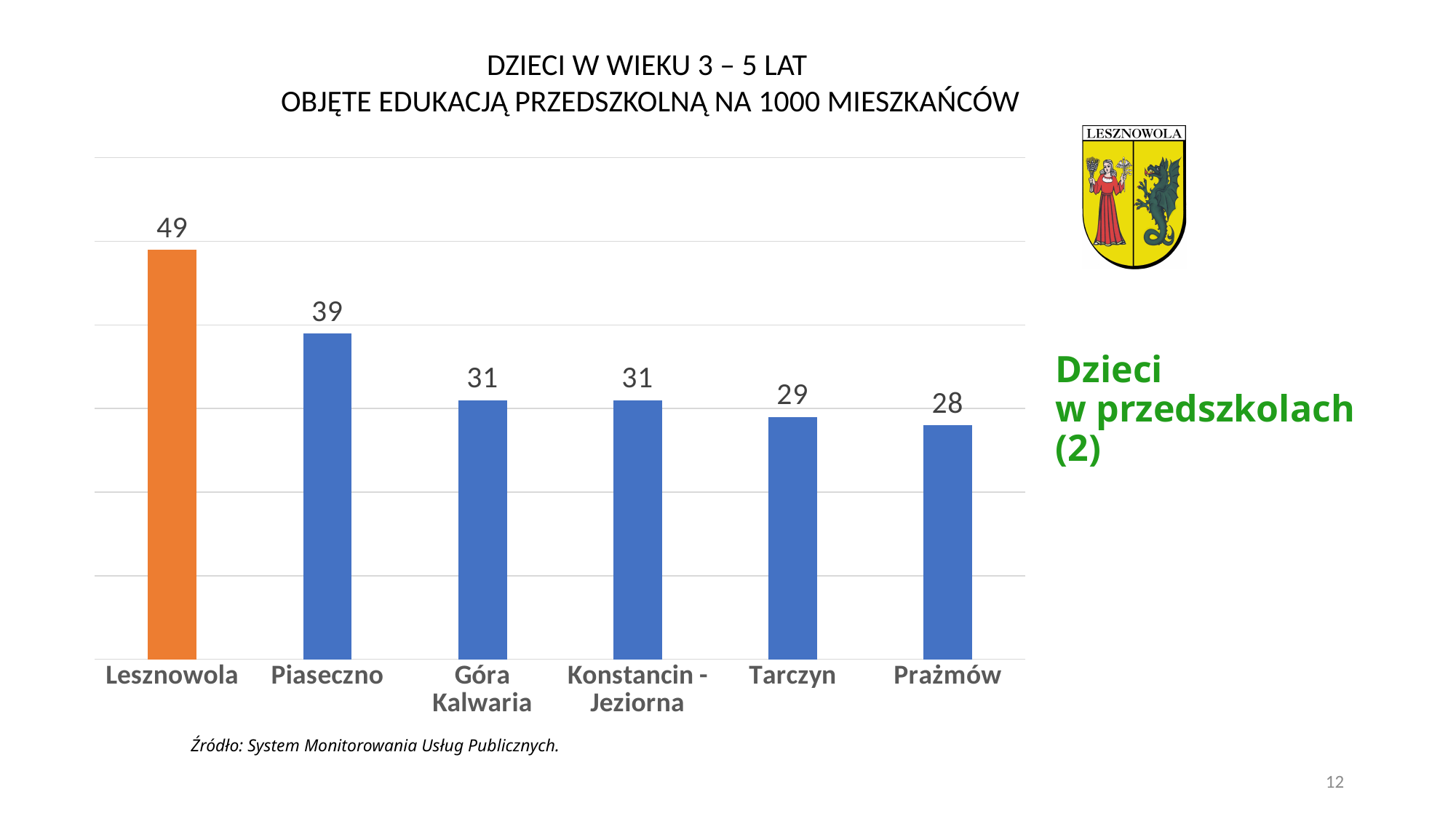
Which category has the highest value? Lesznowola What is the value for Prażmów? 28 What is the value for Tarczyn? 29 What is the difference between the values for Piaseczno and Góra Kalwaria? 8 What is the value for Piaseczno? 39 Which category has the lowest value? Prażmów Which is larger, the value for Piaseczno or the value for Tarczyn? Piaseczno What is the difference between the values for Lesznowola and Piaseczno? 10 What is the value for Lesznowola? 49 What kind of chart is shown on the slide? Bar chart How many categories are shown on the chart? 6 Which bar is coloured orange rather than blue? Lesznowola